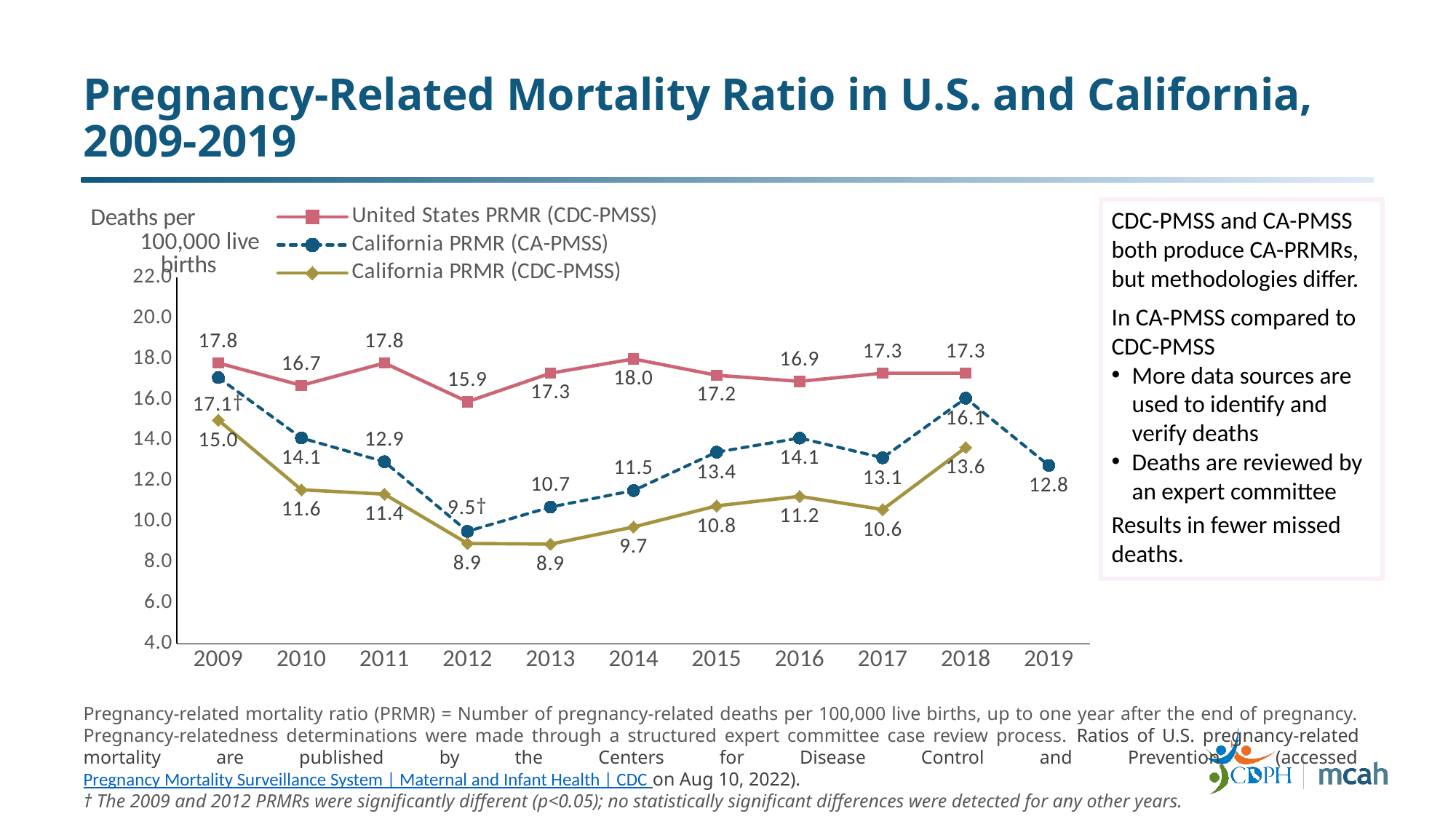
What is the difference between the California PRMR (CA-PMSS) and the California PRMR (CDC-PMSS) in 2009? 2.1 How many series does the legend list? 3 In which year is the United States PRMR (CDC-PMSS) highest? 2014 What is the United States PRMR (CDC-PMSS) value for 2014? 18.0 In 2018, which is larger: the United States PRMR (CDC-PMSS) or the California PRMR (CA-PMSS)? United States PRMR (CDC-PMSS) What is the difference between the United States PRMR (CDC-PMSS) in 2009 and in 2010? 1.1 How many years are shown on the x axis? 11 What is the California PRMR (CDC-PMSS) value for 2012? 8.9 What kind of chart is shown on the slide? Line chart In which year is the California PRMR (CA-PMSS) lowest? 2012 What is the California PRMR (CA-PMSS) value for 2019? 12.8 Does the California PRMR (CDC-PMSS) rise or fall from 2009 to 2012? Fall